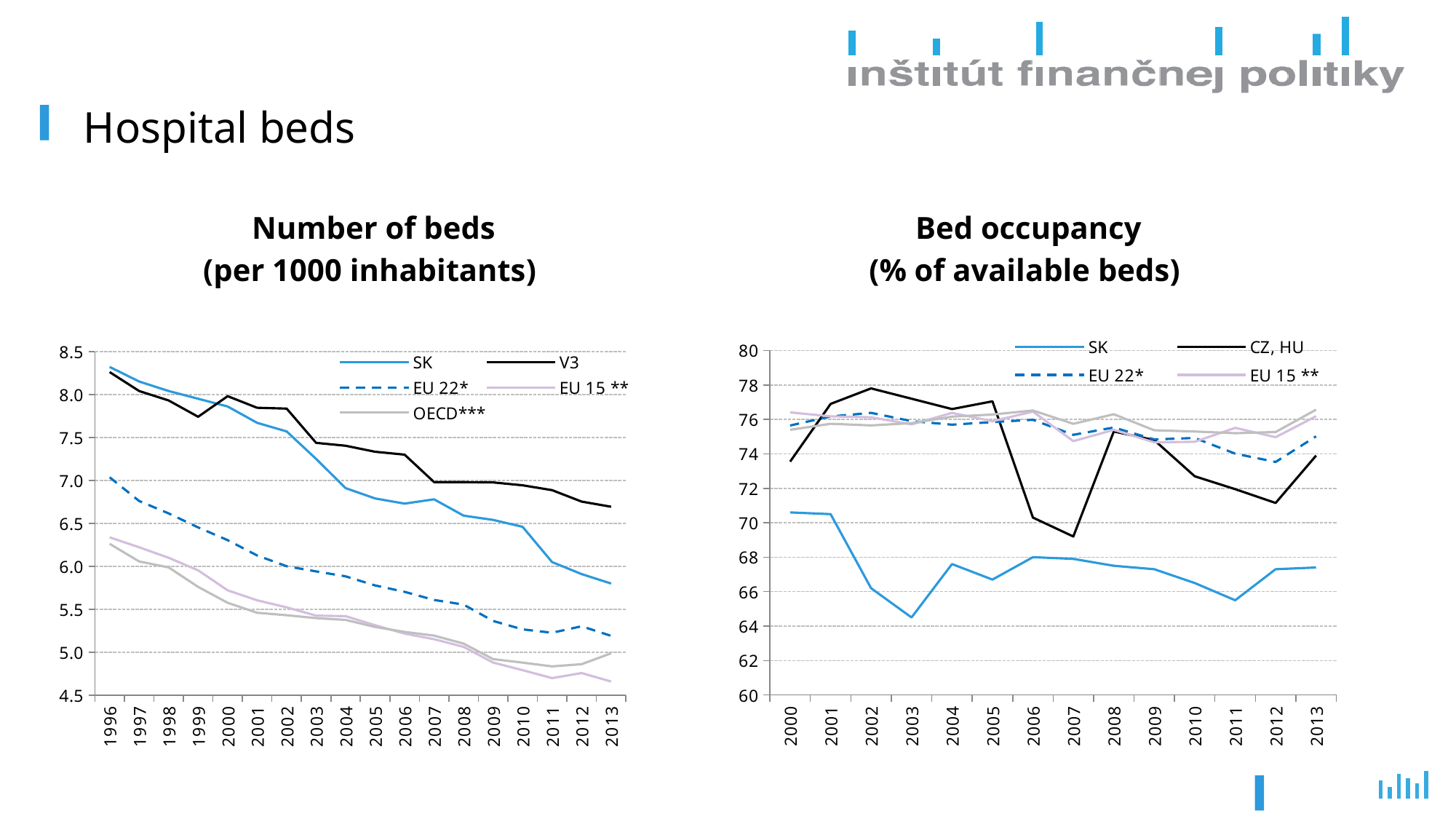
In the "Number of beds (per 1000 inhabitants)" chart, is the value for SK in 2013 greater or less than 6.0? less How many years are shown on the x axis of the "Number of beds (per 1000 inhabitants)" chart? 18 How many years are shown on the x axis of the "Bed occupancy (% of available beds)" chart? 14 In the "Bed occupancy (% of available beds)" chart, is the value for CZ, HU in 2007 greater or less than 70? less In the "Number of beds (per 1000 inhabitants)" chart, does the SK line rise or fall from 1996 to 2013? fall In the "Bed occupancy (% of available beds)" chart, in which year does the SK line reach its lowest value? 2003 How many series does the legend of the "Bed occupancy (% of available beds)" chart list? 4 In the "Number of beds (per 1000 inhabitants)" chart, which series has the highest value in 2013? V3 How many series does the legend of the "Number of beds (per 1000 inhabitants)" chart list? 5 What kind of chart is the "Number of beds (per 1000 inhabitants)" chart? line chart In the "Bed occupancy (% of available beds)" chart, which is higher in 2007: CZ, HU or EU 22*? EU 22* In the "Number of beds (per 1000 inhabitants)" chart, is the value for V3 in 1996 greater or less than 8.0? greater